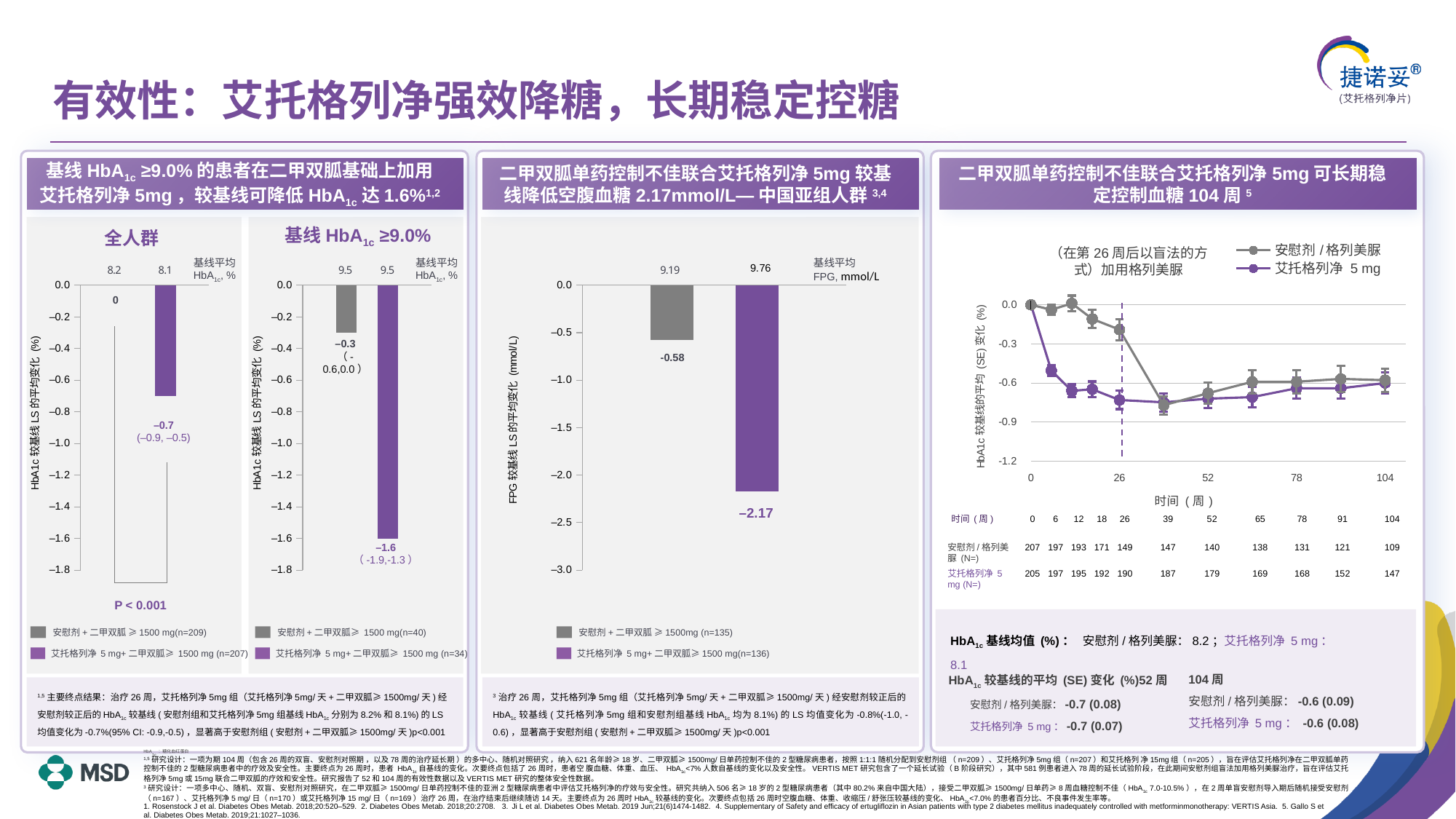
In the middle chart, what is the baseline mean FPG shown above the 艾托格列净 5 mg bar? 9.76 In the table below the right panel's line chart, what is the N for the 艾托格列净 5 mg group at week 104? 147 What kind of chart is shown in the right panel (HbA1c change over 104 weeks)? line chart In the left panel's 基线 HbA1c ≥9.0% chart, which group shows the larger reduction in HbA1c, 安慰剂 or 艾托格列净 5 mg? 艾托格列净 5 mg In the left panel's 基线 HbA1c ≥9.0% chart, what is the LS mean change in HbA1c for the 艾托格列净 5 mg group? –1.6 How many series does the legend of the right panel's line chart list? 2 In the middle chart (FPG change from baseline), what is the LS mean change for the 艾托格列净 5 mg + 二甲双胍 group? −2.17 In the middle chart (FPG change from baseline), what is the difference between the placebo group's change (-0.58) and the ertugliflozin group's change (−2.17)? 1.59 In the middle chart (FPG change from baseline), what is the LS mean change for the 安慰剂 + 二甲双胍 group? -0.58 In the left panel's 基线 HbA1c ≥9.0% chart, what is the LS mean change in HbA1c for the 安慰剂 group? –0.3 In the left panel's 全人群 chart, what is the baseline mean HbA1c shown above the 艾托格列净 5 mg bar? 8.1 In the left panel's 全人群 chart, what is the LS mean change in HbA1c for the 艾托格列净 5 mg group? –0.7